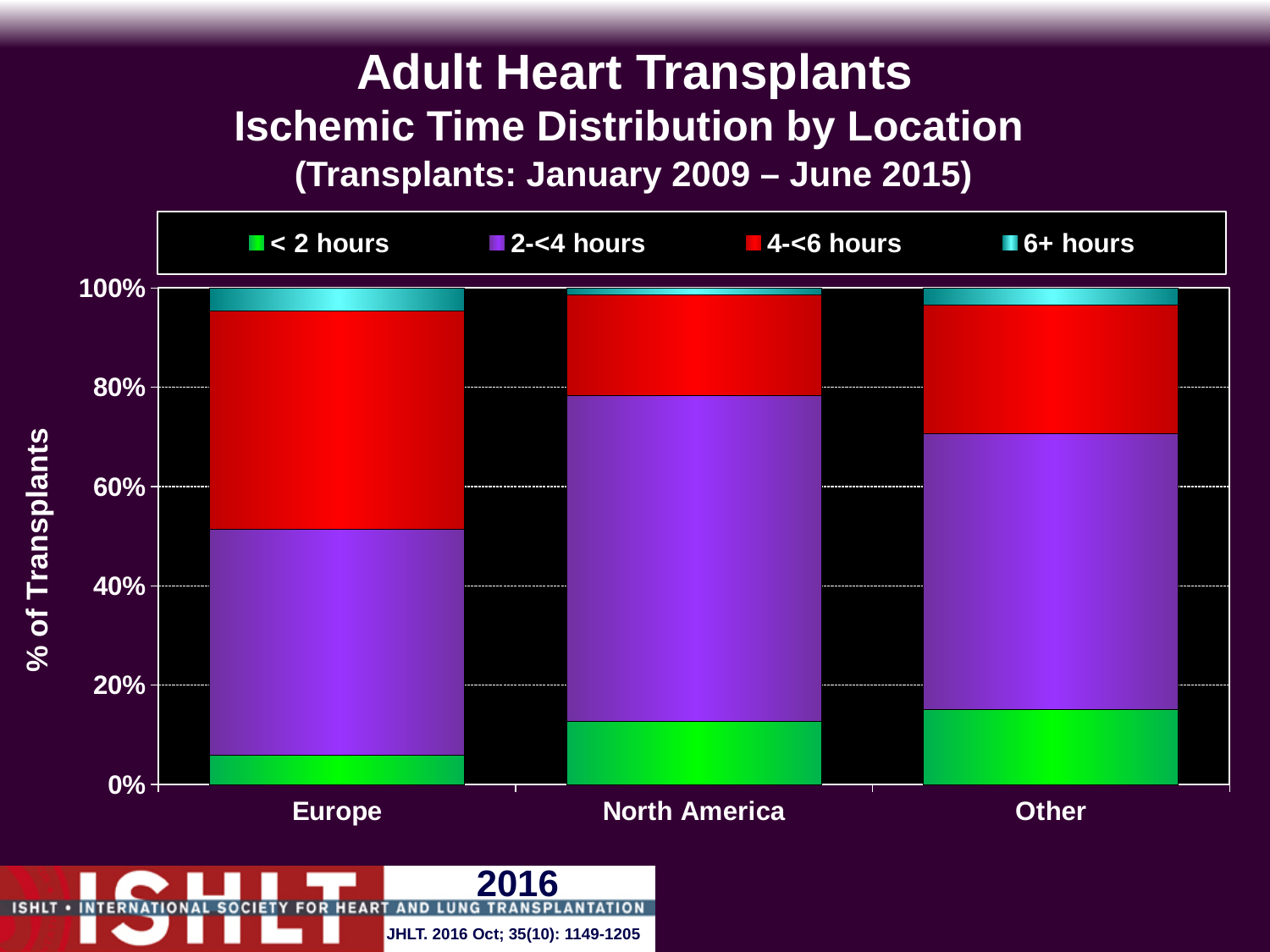
Is the 4-<6 hours segment for Europe greater or less than 40%? greater Which location has the largest 4-<6 hours segment? Europe Which legend entry is shown in green? < 2 hours What kind of chart is shown on the slide? stacked bar chart How many locations are shown on the x axis of the chart? 3 Is the < 2 hours segment for Europe greater or less than 20%? less Which location has the largest 2-<4 hours segment? North America How many ischemic time categories does the legend list? 4 Is the 4-<6 hours segment for Europe larger or smaller than the 4-<6 hours segment for North America? larger Which location has the smallest < 2 hours segment? Europe What is the label on the y axis of the chart? % of Transplants Is the 2-<4 hours segment for North America greater or less than 60%? greater